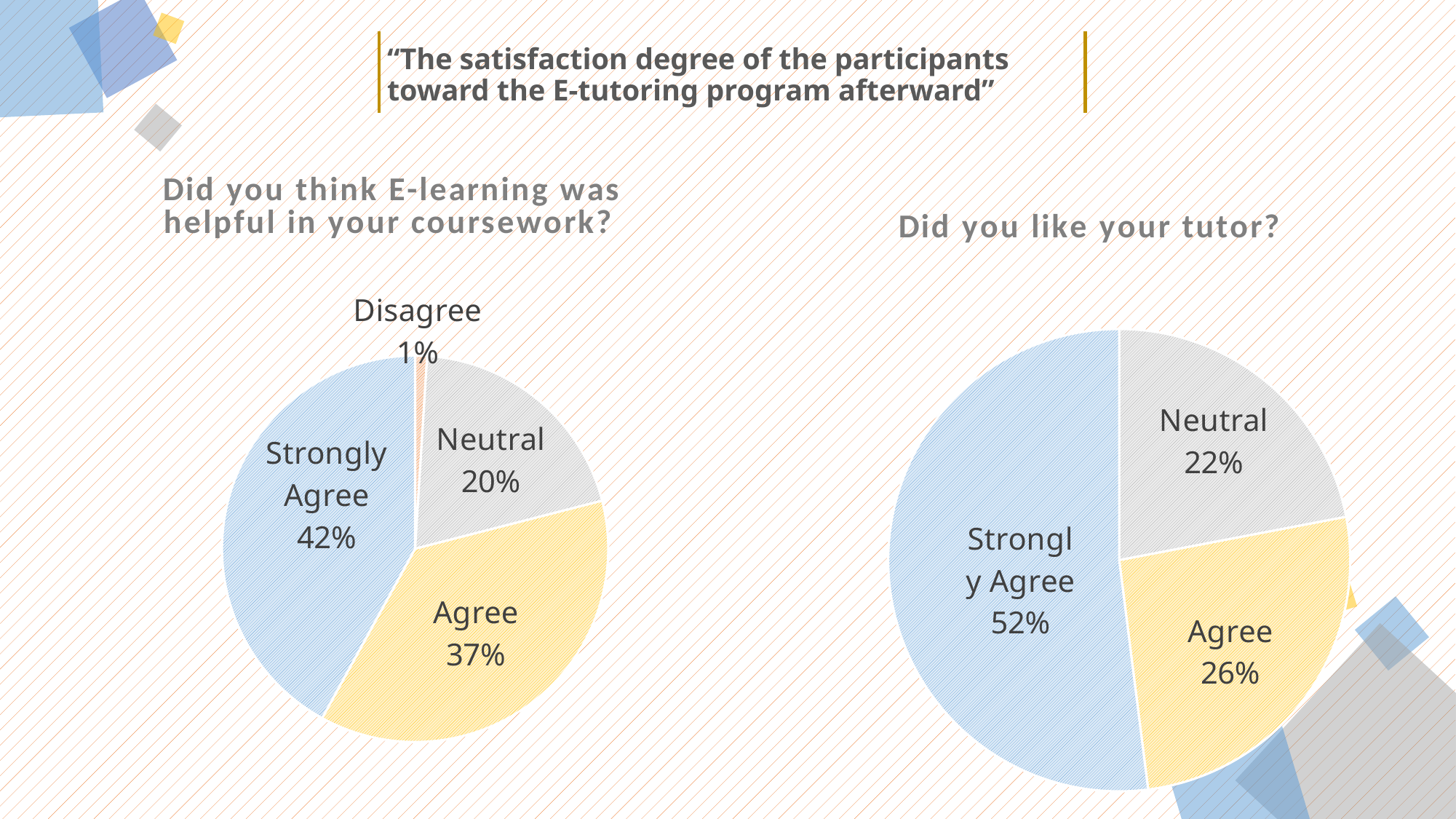
In the 'Did you think E-learning was helpful in your coursework?' pie chart, what percentage is shown for Neutral? 20% In the 'Did you think E-learning was helpful in your coursework?' pie chart, what is the difference in percentage points between Strongly Agree and Agree? 5 What type of chart is used for 'Did you like your tutor?'? Pie chart In the 'Did you like your tutor?' pie chart, what percentage is shown for Agree? 26% In the 'Did you like your tutor?' pie chart, which category has the largest slice? Strongly Agree In the 'Did you think E-learning was helpful in your coursework?' pie chart, which is larger, Neutral or Agree? Agree How many slices does the 'Did you like your tutor?' pie chart have? 3 In the 'Did you think E-learning was helpful in your coursework?' pie chart, what percentage is shown for Strongly Agree? 42% In the 'Did you think E-learning was helpful in your coursework?' pie chart, which category has the smallest slice? Disagree In the 'Did you like your tutor?' pie chart, what is the difference in percentage points between Strongly Agree and Neutral? 30 In the 'Did you like your tutor?' pie chart, what percentage is shown for Strongly Agree? 52% How many slices does the 'Did you think E-learning was helpful in your coursework?' pie chart have? 4